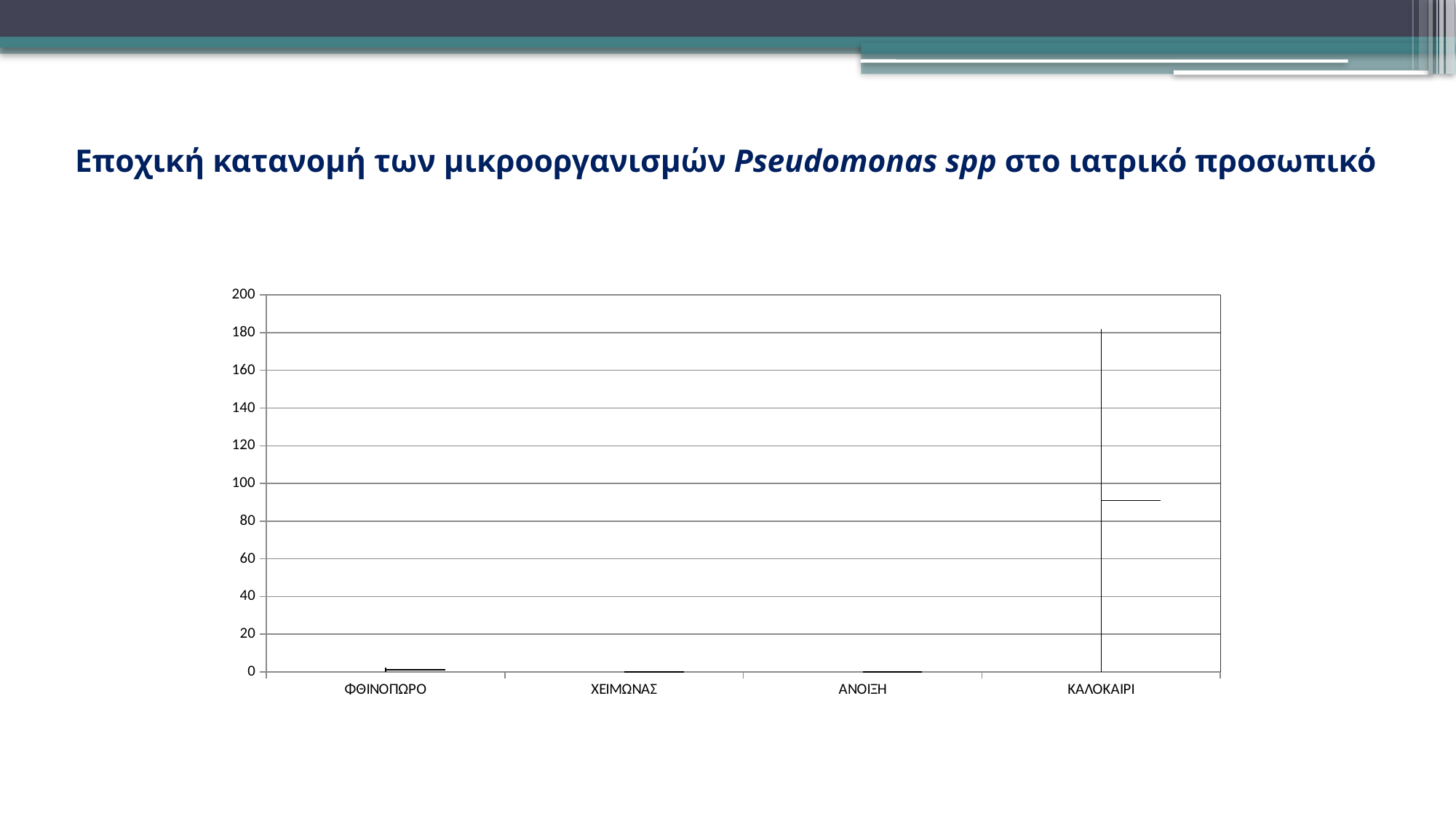
Is the value for ΦΘΙΝΟΠΩΡΟ greater or less than 20? less Is the value for ΧΕΙΜΩΝΑΣ greater or less than 40? less What is the maximum value shown on the y axis of the chart? 200 Which is larger, the value for ΚΑΛΟΚΑΙΡΙ or the value for ΑΝΟΙΞΗ? ΚΑΛΟΚΑΙΡΙ What kind of chart is shown on the slide? stock chart (high-low-close chart) What is the title of the slide containing the chart? Εποχική κατανομή των μικροοργανισμών Pseudomonas spp στο ιατρικό προσωπικό How many categories are shown on the x axis of the chart? 4 Which is larger, the value for ΚΑΛΟΚΑΙΡΙ or the value for ΧΕΙΜΩΝΑΣ? ΚΑΛΟΚΑΙΡΙ Which category has the highest value in the chart? ΚΑΛΟΚΑΙΡΙ Is the value for ΑΝΟΙΞΗ greater or less than 20? less